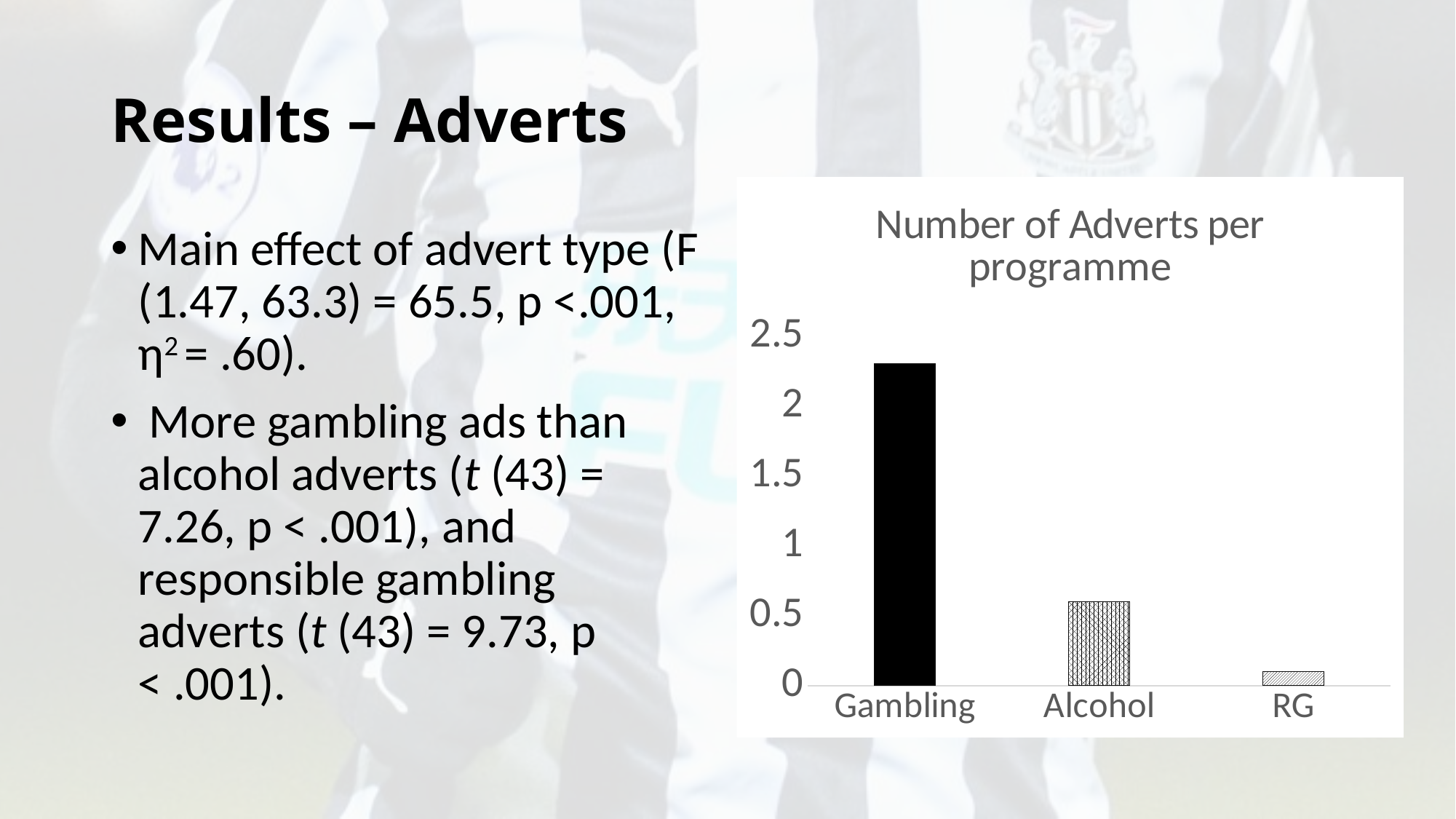
Which is larger, the value for Alcohol or the value for RG? Alcohol Which category has the lowest number of adverts per programme? RG Is the value for Gambling greater or less than 2.5? less Is the value for Alcohol greater or less than 1? less Do the values rise or fall moving from Gambling to RG along the x axis? fall Which category has the highest number of adverts per programme? Gambling What is the highest value labelled on the y axis of the chart? 2.5 How many categories are shown on the x axis of the chart? 3 Is the value for Gambling greater or less than 2? greater What kind of chart is shown on the slide? bar chart What is the title of the chart? Number of Adverts per programme